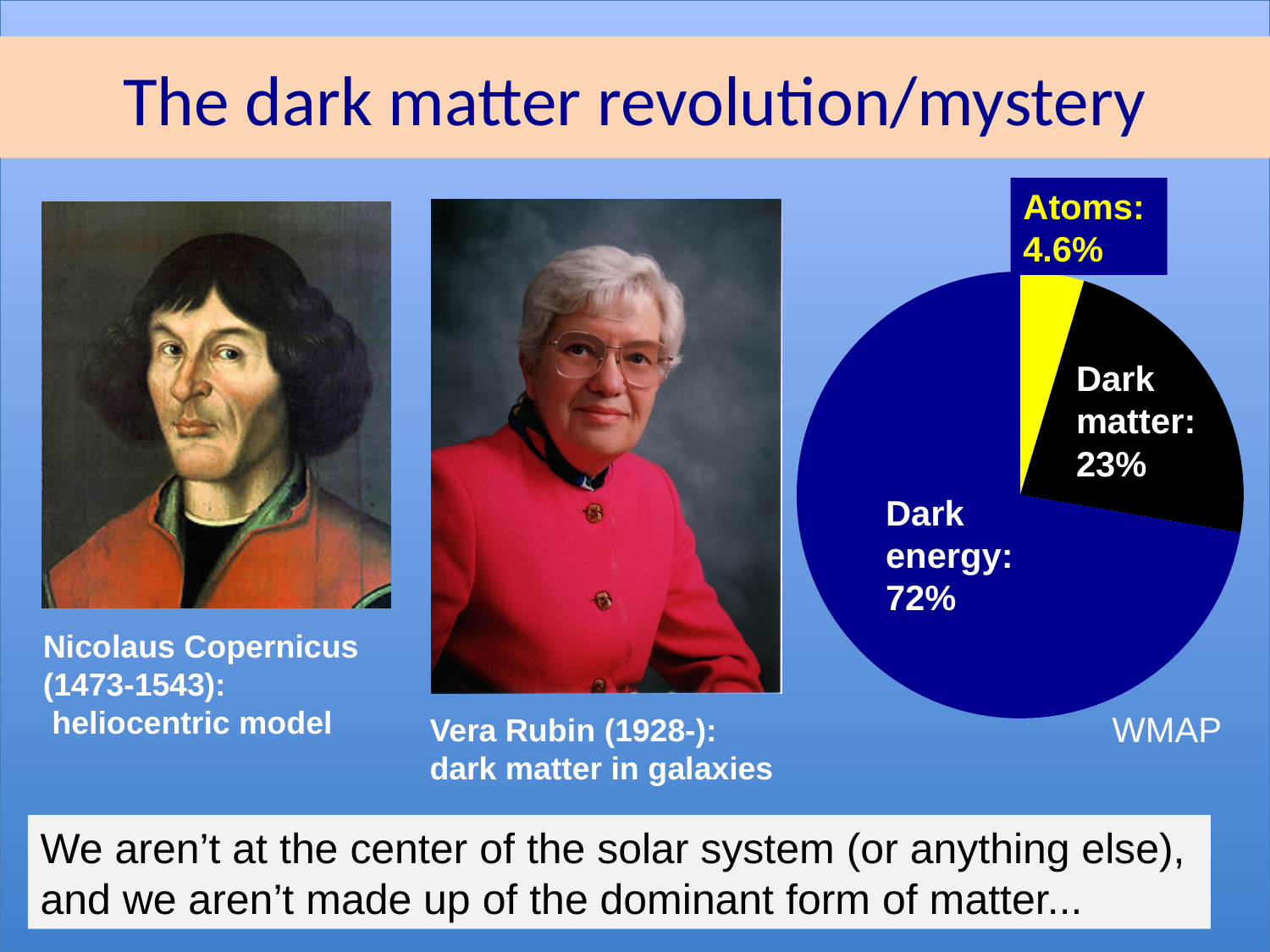
What share of the pie chart is labelled Dark energy? 72% What colour is the Atoms slice in the pie chart? yellow Which is larger in the pie chart, Dark matter or Atoms? Dark matter What source label appears below the pie chart? WMAP What is the difference between the Dark matter and Atoms shares in the pie chart? 18.4% Which slice of the pie chart is the largest? Dark energy Which slice of the pie chart is the smallest? Atoms How many slices does the pie chart have? 3 What share of the pie chart is labelled Atoms? 4.6% What share of the pie chart is labelled Dark matter? 23% What is the difference between the Dark energy and Dark matter shares in the pie chart? 49% What kind of chart is shown on the slide? pie chart